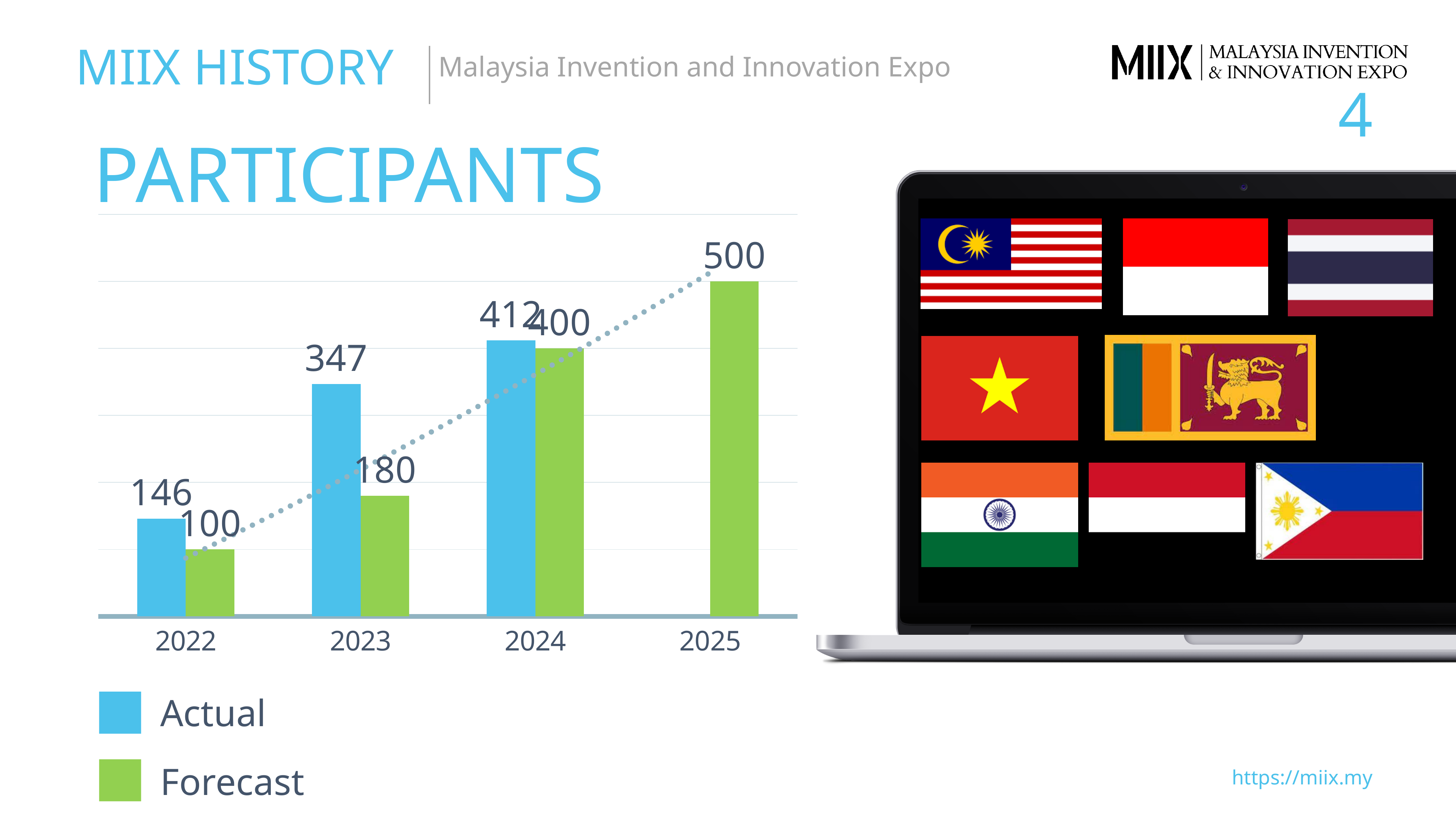
What is the Forecast number of participants for 2025? 500 What is the Forecast value for 2022? 100 Which is larger in 2022, the Actual value or the Forecast value? Actual What is the difference between the Actual and Forecast values in 2023? 167 What is the Actual value for 2024? 412 Which year has the lowest Forecast value? 2022 What kind of chart is shown on the slide? Bar chart How many series does the legend list? 2 Which year has the highest Actual value? 2024 Do the Forecast values rise or fall from 2022 to 2025? Rise What is the Actual number of participants in 2023? 347 How many years are shown on the x axis? 4